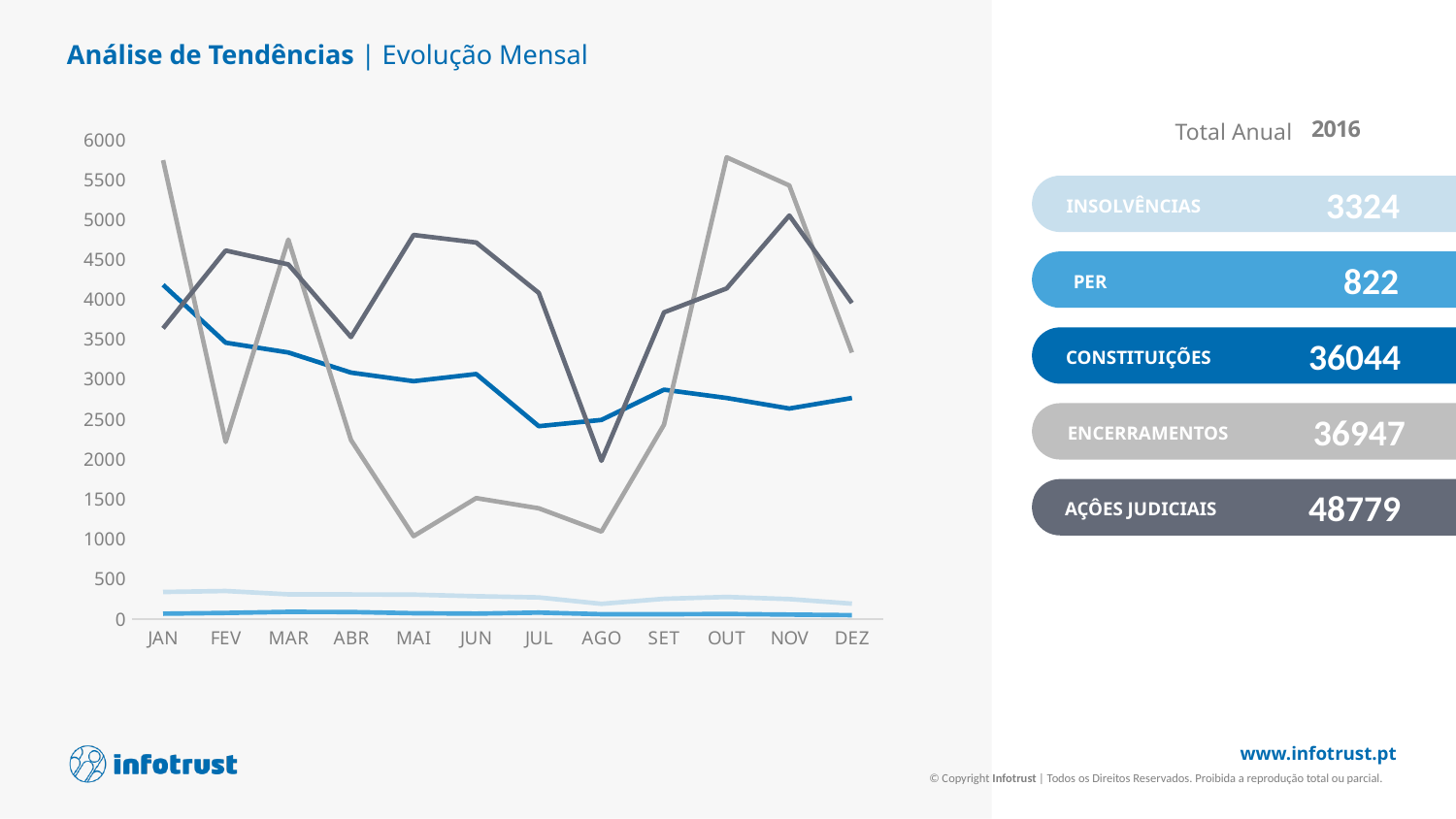
Is the value of the dark slate-grey line in AGO greater or less than 2500? less What kind of chart is shown on the slide? line chart Does the medium blue line generally rise or fall from JAN to DEZ? fall What is the highest value shown on the chart's vertical axis? 6000 In MAI, which line is higher: the dark slate-grey line or the light grey line? the dark slate-grey line What is the title of the chart slide? Análise de Tendências | Evolução Mensal In which month does the dark slate-grey line reach its highest point? NOV Is the value of the light grey line in MAI greater or less than 1500? less In JAN, which line is higher: the light grey line or the dark slate-grey line? the light grey line In which month does the dark slate-grey line reach its lowest point? AGO How many months are plotted along the x axis of the chart? 12 Is the value of the light grey line in JAN greater or less than 5500? greater